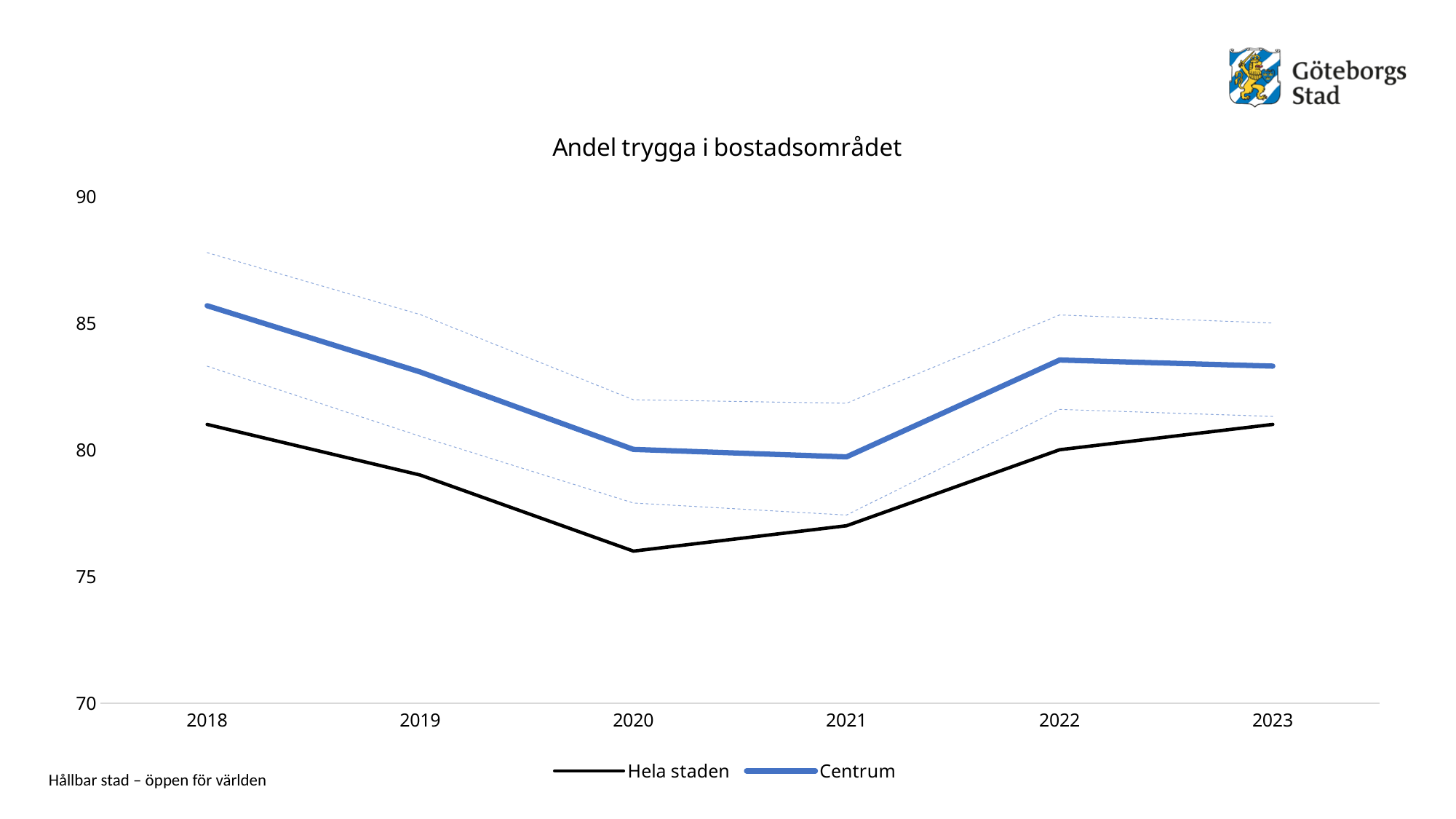
Which series is drawn with the blue line? Centrum Does the value for Hela staden rise or fall from 2020 to 2023? rise In which year is the value for Hela staden lowest? 2020 Is the value for Hela staden in 2020 greater or less than 75? greater How many series does the legend list? 2 What kind of chart is shown on the slide? line chart What is the title of the chart? Andel trygga i bostadsområdet Is the value for Centrum in 2021 greater or less than 85? less Is the value for Hela staden in 2020 greater or less than 80? less Which series has the higher value in 2018, Hela staden or Centrum? Centrum How many years are shown on the x axis? 6 In which year is the value for Centrum highest? 2018